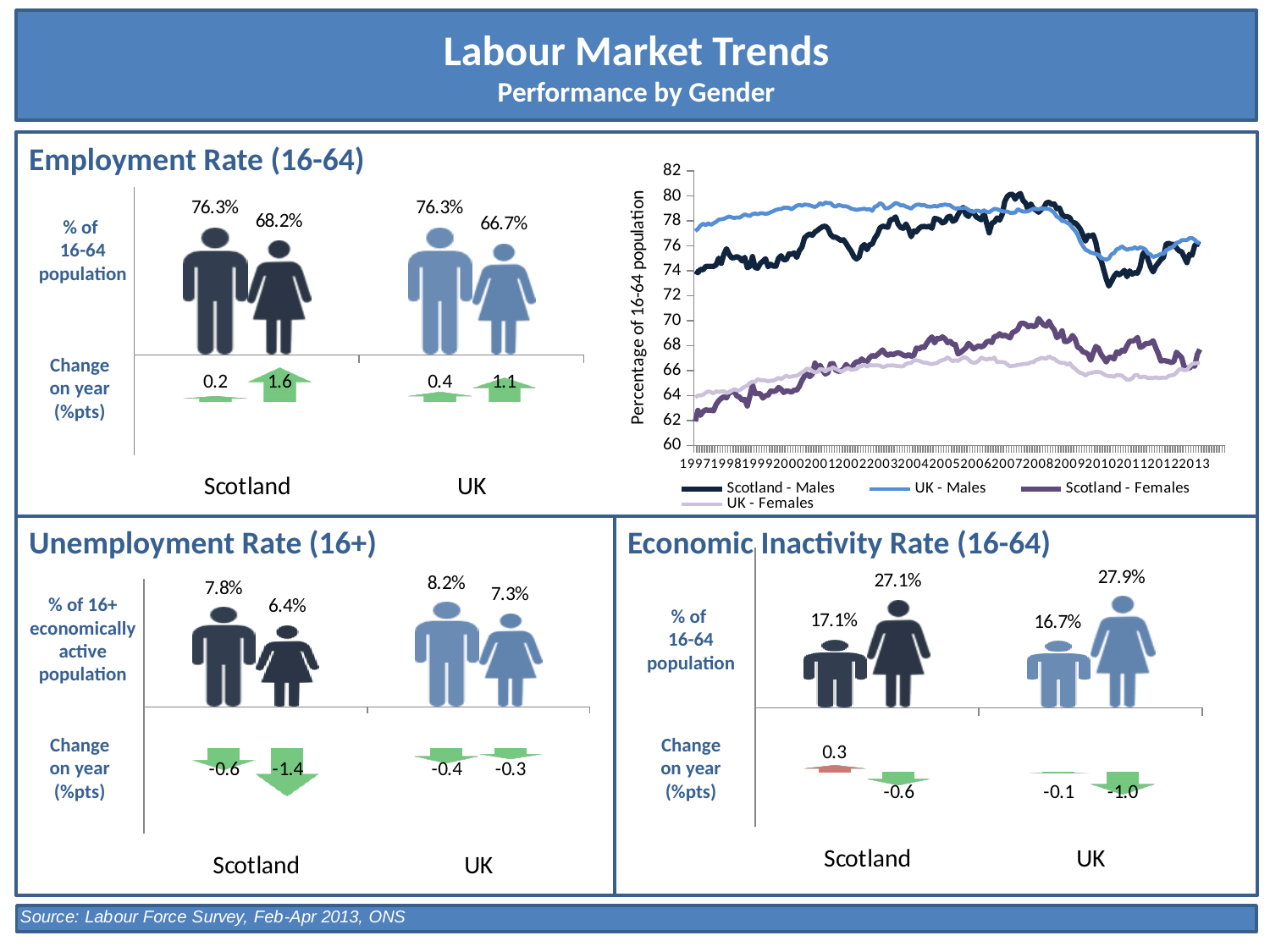
In the Economic Inactivity Rate (16-64) chart, what is the change on year (%pts) for males in Scotland? 0.3 In the Unemployment Rate (16+) chart, which is larger: the male unemployment rate in Scotland or in the UK? UK In the Unemployment Rate (16+) chart, what is the change on year (%pts) for females in Scotland? -1.4 In the Economic Inactivity Rate (16-64) chart, what is the difference between the female and male inactivity rates in the UK? 11.2 percentage points In the Economic Inactivity Rate (16-64) chart, what is the inactivity rate for males in the UK? 16.7% How many series does the legend of the line chart in the top right list? 4 In the Employment Rate (16-64) chart, what is the employment rate for females in Scotland? 68.2% In the top-right line chart, does the Scotland - Females series rise or fall overall from 1997 to 2013? Rise What kind of chart is the chart in the top right showing percentage of 16-64 population from 1997 to 2013? Line chart In the Employment Rate (16-64) chart, what is the change on year (%pts) for females in the UK? 1.1 In the Employment Rate (16-64) chart, what is the difference between the male and female employment rates in Scotland? 8.1 percentage points In the Unemployment Rate (16+) chart, what is the unemployment rate for females in the UK? 7.3%